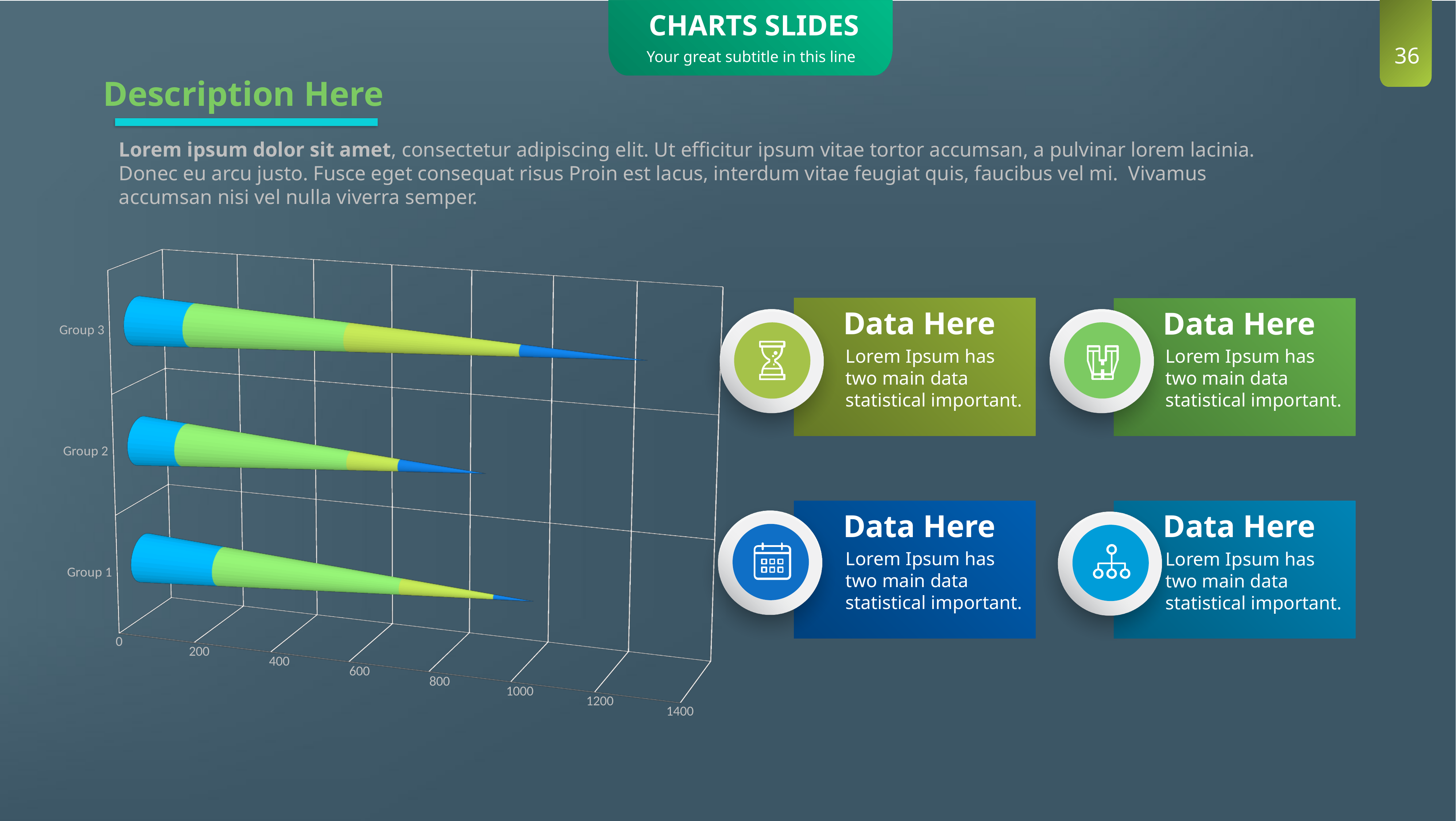
How many groups (categories) are plotted on the chart? 3 What is the highest value shown on the horizontal axis? 1400 Which group has the shortest bar on the chart? Group 2 Which bar is longer, Group 1 or Group 2? Group 1 Which group has the longest bar on the chart? Group 3 Is the total value for Group 3 greater or less than 1000? greater Is the total value for Group 1 greater or less than 600? greater What is the interval between consecutive tick labels on the horizontal axis? 200 Is the total value for Group 2 greater or less than 1000? less What kind of chart is shown on the slide? bar chart